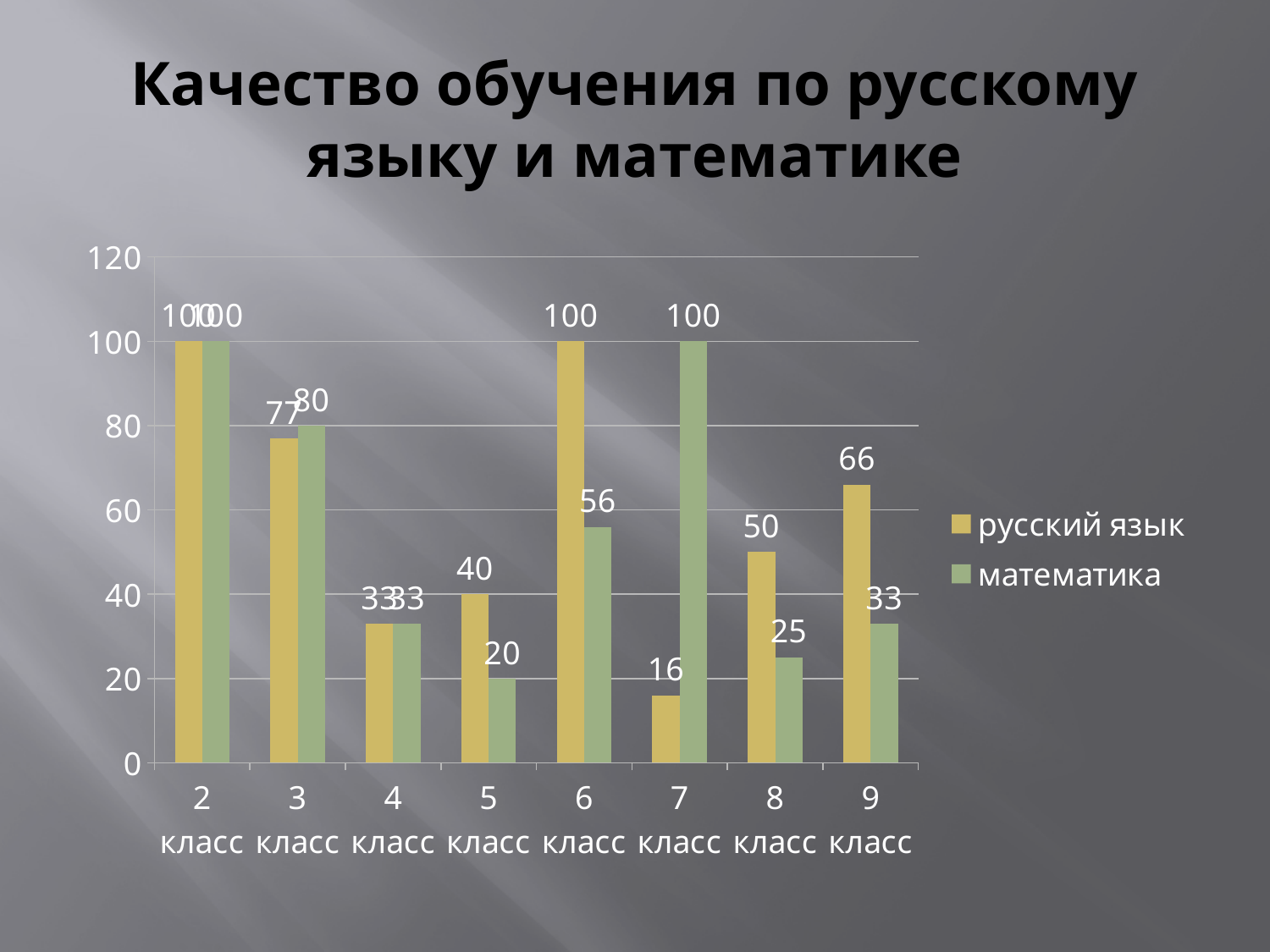
Which class has the lowest value for математика? 5 класс How many series does the legend list? 2 What is the value for математика in 5 класс? 20 Which series is shown in green? математика What is the difference between русский язык and математика in 7 класс? 84 How many classes (categories) are shown on the x axis? 8 What is the value for математика in 6 класс? 56 What type of chart is shown on the slide? bar chart What is the value for русский язык in 7 класс? 16 What is the value for русский язык in 9 класс? 66 Which class has the lowest value for русский язык? 7 класс In 8 класс, which is larger: русский язык or математика? русский язык